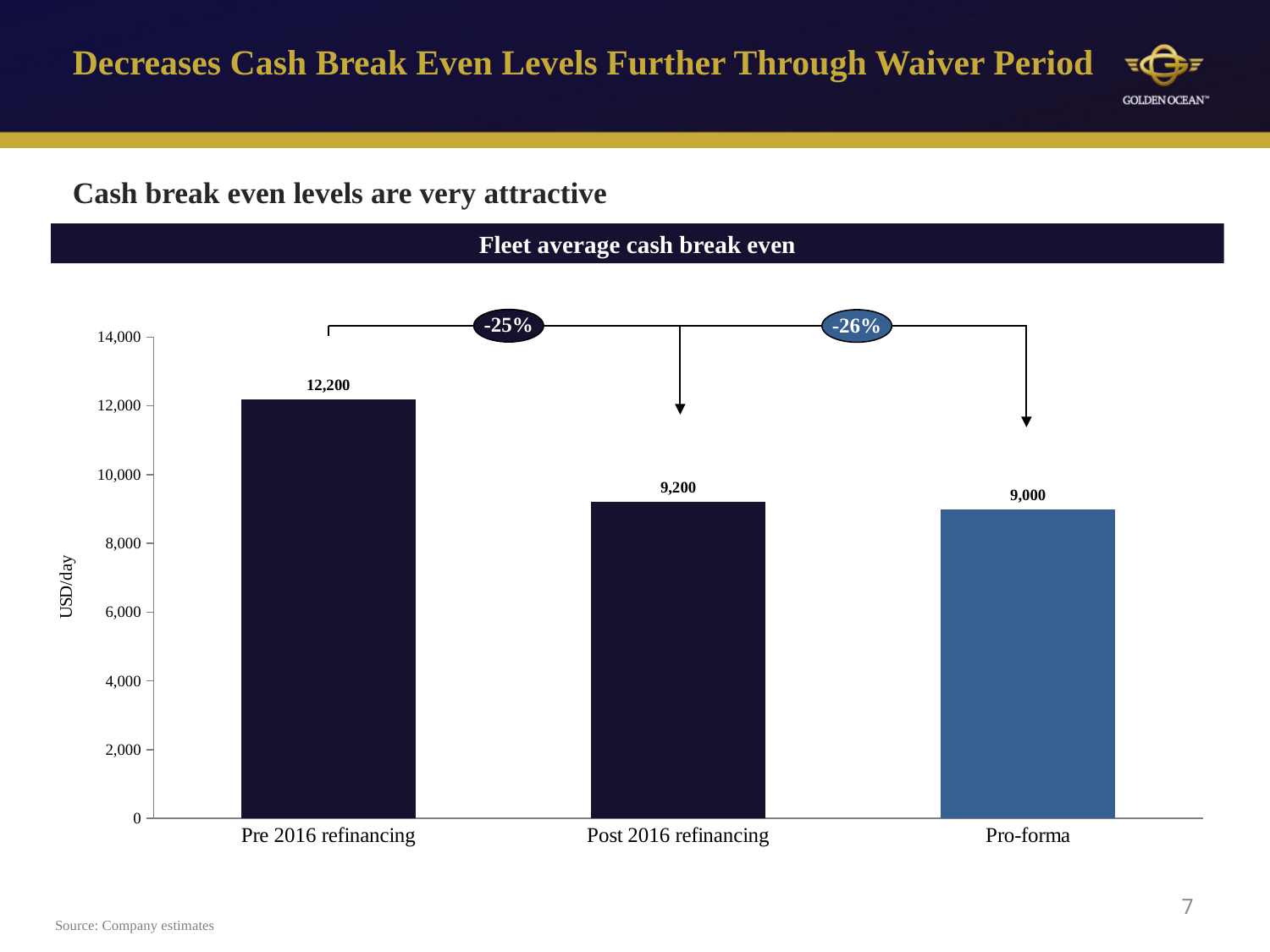
How many categories are shown on the chart? 3 Which is larger, the cash break even for Pre 2016 refinancing or for Pro-forma? Pre 2016 refinancing What is the difference between the Pre 2016 refinancing and Post 2016 refinancing cash break even levels? 3,000 Which category has the highest cash break even level? Pre 2016 refinancing Which category has the lowest cash break even level? Pro-forma What kind of chart is shown on the slide? Bar chart What is the difference between the Post 2016 refinancing and Pro-forma cash break even levels? 200 What is the fleet average cash break even for Pro-forma? 9,000 What is the fleet average cash break even for Pre 2016 refinancing? 12,200 What percentage change is annotated between Post 2016 refinancing and Pro-forma? -26% Is the value for Post 2016 refinancing greater or less than 10,000? less What is the fleet average cash break even for Post 2016 refinancing? 9,200